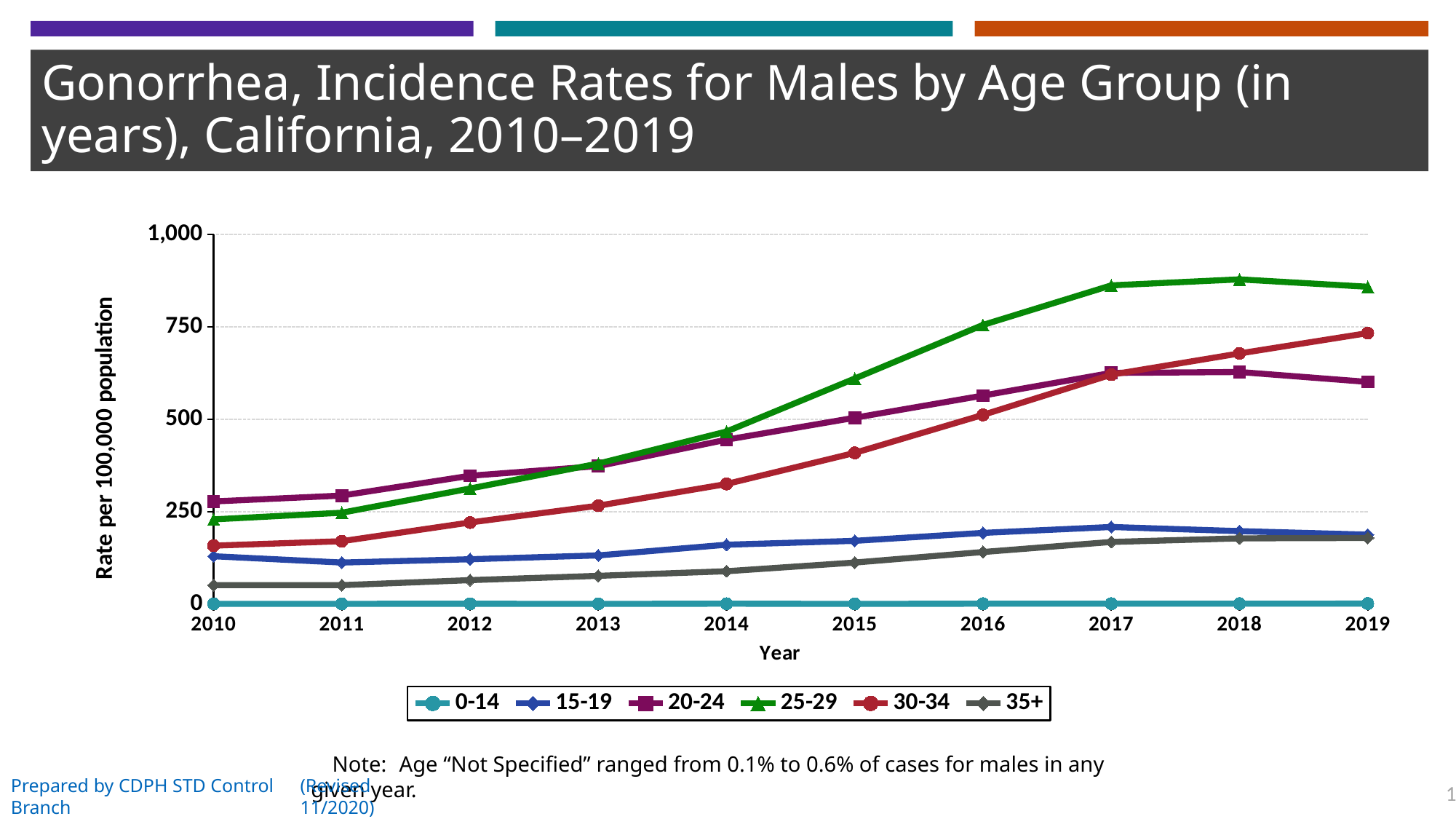
Is the value for the 25-29 age group in 2018 greater or less than 750? greater Does the rate for the 25-29 age group rise or fall from 2010 to 2018? rise Is the value for the 30-34 age group in 2010 greater or less than 250? less What is the label of the y axis? Rate per 100,000 population Is the value for the 20-24 age group in 2019 greater or less than 500? greater In 2019, which has the larger rate: the 30-34 age group or the 20-24 age group? 30-34 Which age group has the highest incidence rate in 2019? 25-29 What kind of chart is shown on the slide? line chart How many age-group series does the legend list? 6 In 2010, which has the larger rate: the 20-24 age group or the 25-29 age group? 20-24 How many years are plotted along the x axis? 10 Which age group has the lowest incidence rate across all years? 0-14